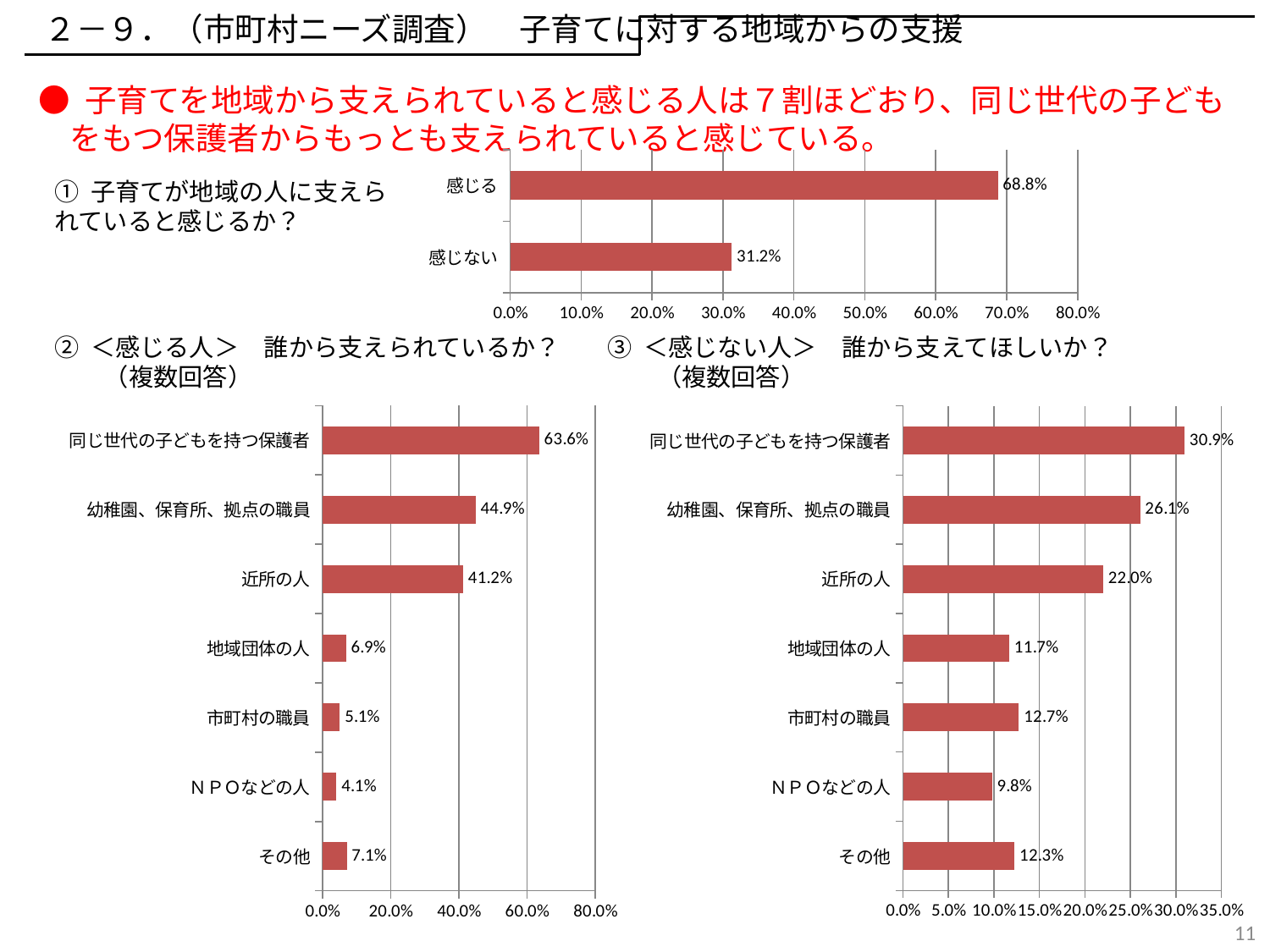
In chart ① (子育てが地域の人に支えられていると感じるか？), what is the value for 感じない? 31.2% In chart ③ (＜感じない人＞ 誰から支えてほしいか？), which is larger: 地域団体の人 or その他? その他 In chart ① (子育てが地域の人に支えられていると感じるか？), what is the value for 感じる? 68.8% In chart ② (＜感じる人＞ 誰から支えられているか？), which category has the lowest value? ＮＰＯなどの人 In chart ① (子育てが地域の人に支えられていると感じるか？), what is the difference between 感じる and 感じない? 37.6% In chart ③ (＜感じない人＞ 誰から支えてほしいか？), what is the difference between 同じ世代の子どもを持つ保護者 and 幼稚園、保育所、拠点の職員? 4.8% In chart ② (＜感じる人＞ 誰から支えられているか？), what is the value for 近所の人? 41.2% In chart ② (＜感じる人＞ 誰から支えられているか？), how many categories are shown? 7 In chart ③ (＜感じない人＞ 誰から支えてほしいか？), which category has the lowest value? ＮＰＯなどの人 What kind of chart is chart ② (＜感じる人＞ 誰から支えられているか？)? Bar chart In chart ② (＜感じる人＞ 誰から支えられているか？), which category has the highest value? 同じ世代の子どもを持つ保護者 In chart ③ (＜感じない人＞ 誰から支えてほしいか？), what is the value for 市町村の職員? 12.7%